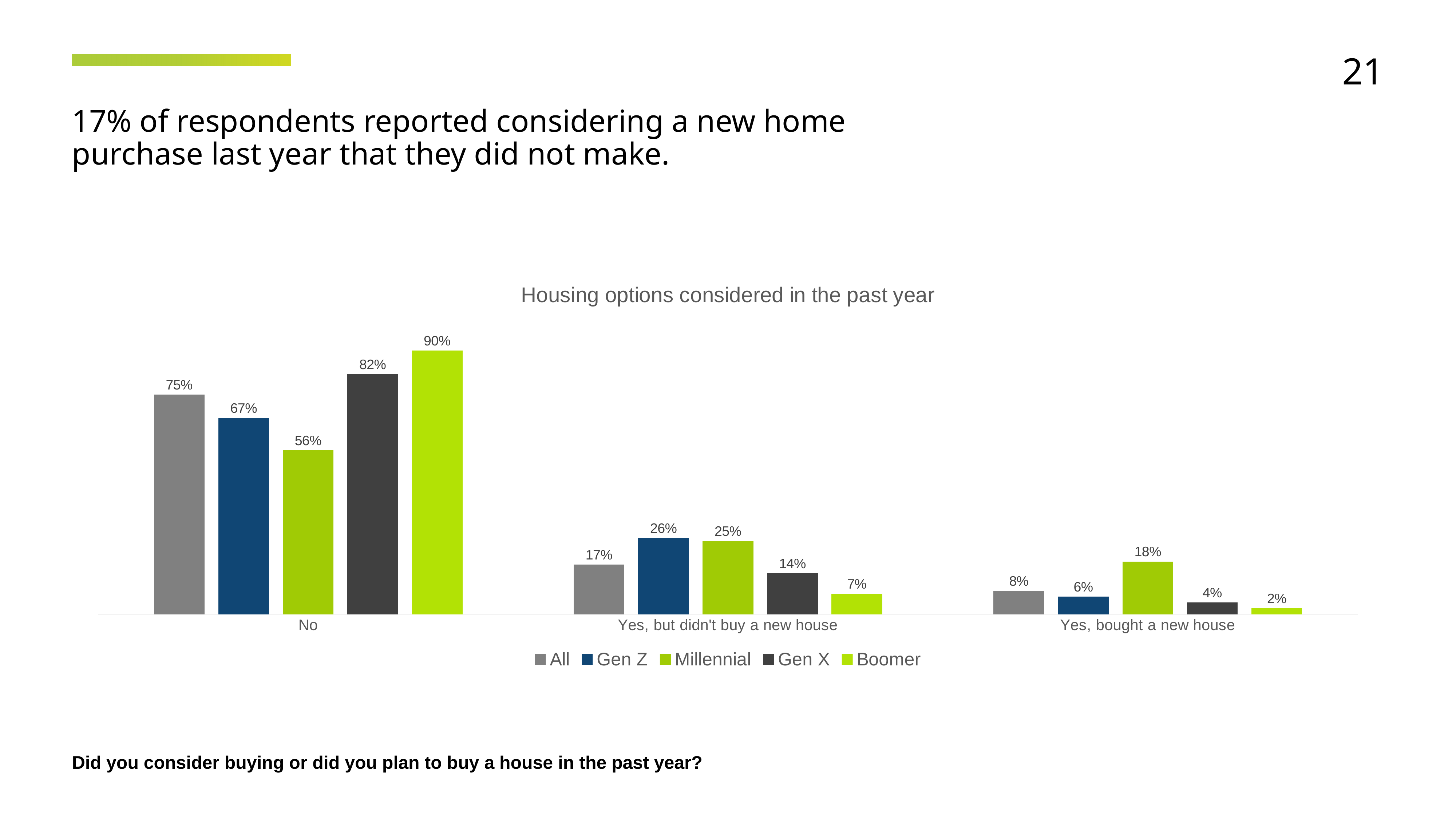
What is the title of the chart? Housing options considered in the past year Which series has the highest value in the "No" category? Boomer Which series has the lowest value in the "Yes, bought a new house" category? Boomer How many series does the legend list? 5 What is the difference between the Boomer and Millennial values in the "No" category? 34% What kind of chart is shown on the slide? Bar chart What is the difference between the Millennial and Gen X values in the "Yes, bought a new house" category? 14% What is the value for Boomer in the "No" category? 90% What is the value for Millennial in the "Yes, bought a new house" category? 18% What is the value for Gen Z in the "Yes, but didn't buy a new house" category? 26% Which is larger in the "Yes, but didn't buy a new house" category: Gen X or Boomer? Gen X How many categories are shown on the x axis? 3